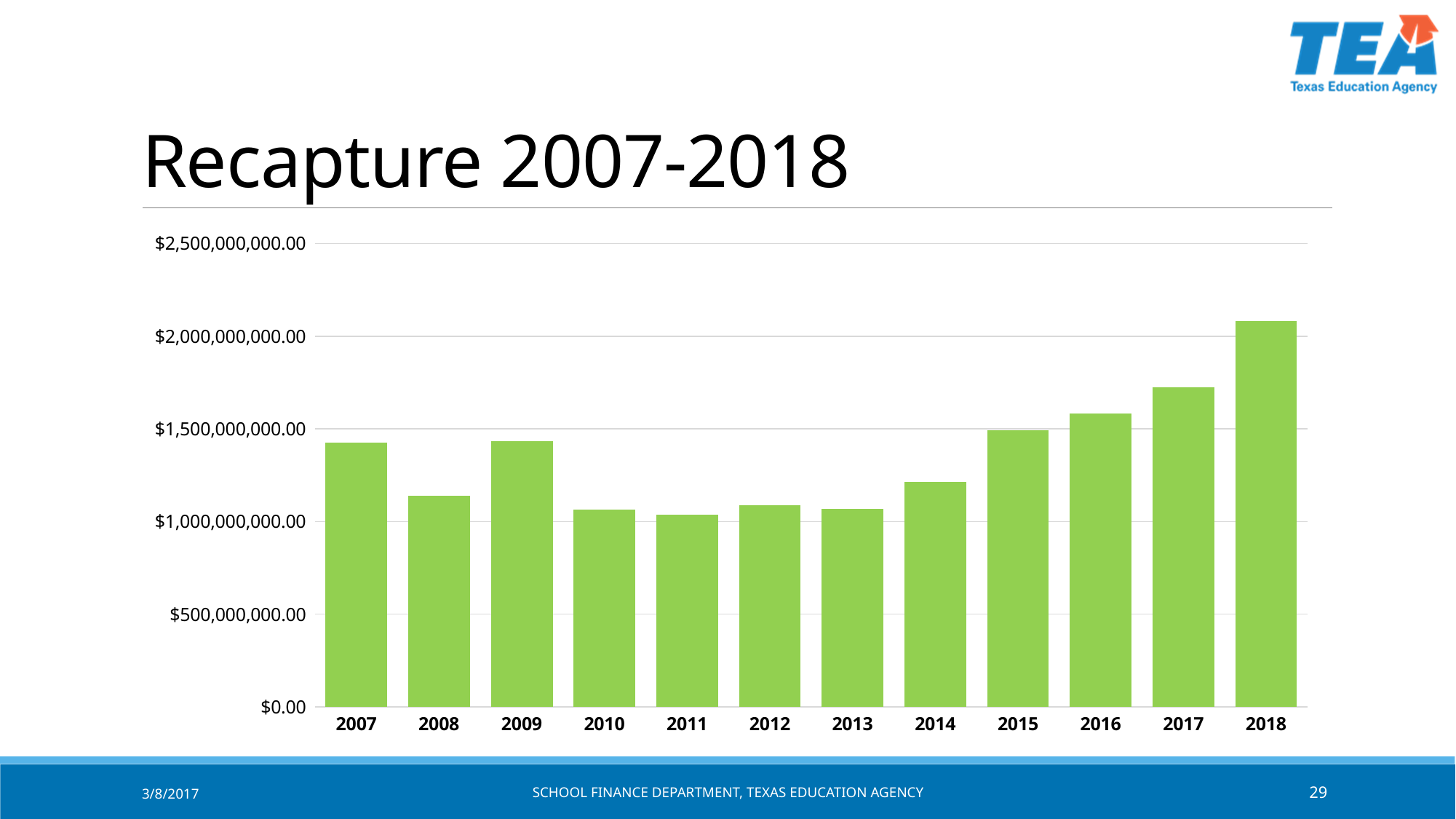
Which year has the highest recapture value? 2018 Is the value for 2018 greater or less than $2,000,000,000.00? greater Is the value for 2017 greater or less than $1,500,000,000.00? greater What kind of chart is shown on the slide? bar chart Which is larger, the value for 2008 or the value for 2010? 2008 Which is larger, the value for 2015 or the value for 2016? 2016 Do the values rise or fall from 2013 to 2018? rise What is the title of the chart? Recapture 2007-2018 Is the value for 2011 greater or less than $1,000,000,000.00? greater How many years are plotted on the x axis? 12